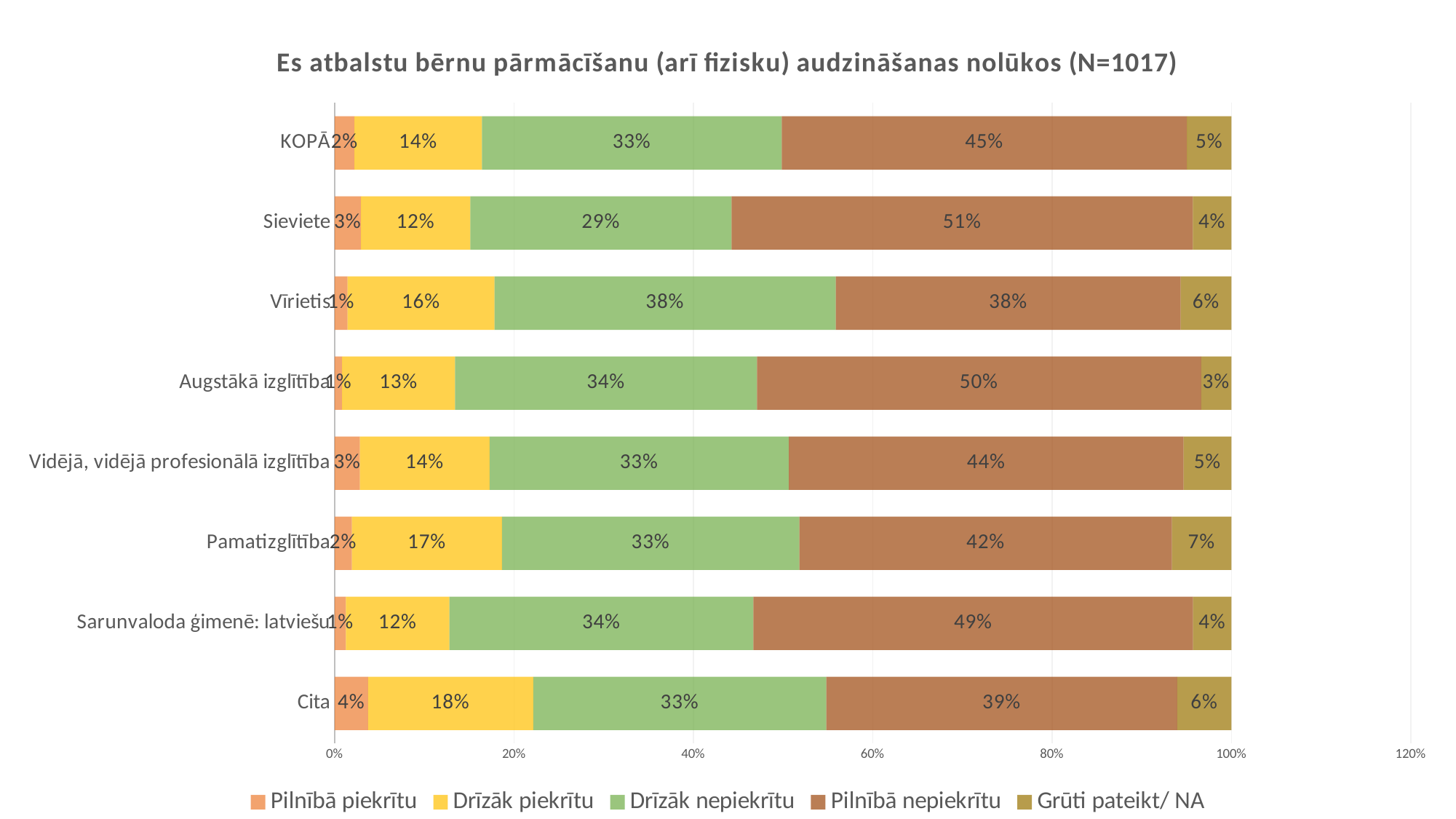
What is the title of the chart? Es atbalstu bērnu pārmācīšanu (arī fizisku) audzināšanas nolūkos (N=1017) How many categories are shown on the chart? 8 What is the value for 'Drīzāk nepiekrītu' in the Vīrietis category? 38% What is the value for 'Pilnībā nepiekrītu' in the Sieviete category? 51% What is the value for 'Grūti pateikt/ NA' in the Pamatizglītība category? 7% Which category has the highest value for 'Pilnībā nepiekrītu'? Sieviete How many series does the legend list? 5 What is the value for 'Drīzāk piekrītu' in the Cita category? 18% Which category has the lowest value for 'Drīzāk nepiekrītu'? Sieviete What is the difference between the 'Pilnībā nepiekrītu' values for Sieviete and Vīrietis? 13% Which is larger: the 'Drīzāk piekrītu' value for Cita or for Augstākā izglītība? Cita What kind of chart is this? Stacked bar chart